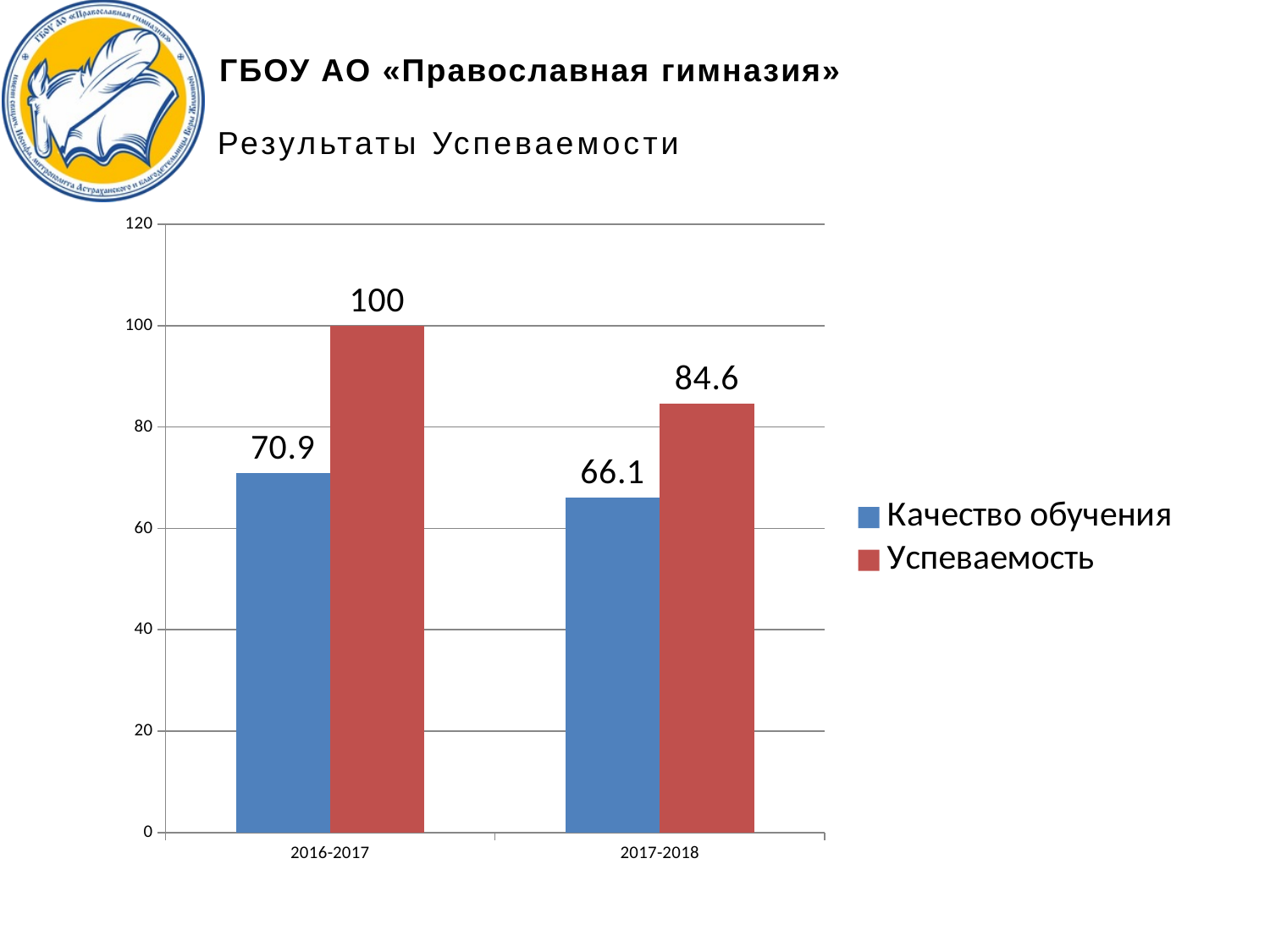
What kind of chart is shown on the slide? bar chart What is the value of Успеваемость for 2017-2018? 84.6 Which category has the lowest Качество обучения value? 2017-2018 What is the value of Качество обучения for 2017-2018? 66.1 What is the difference between Успеваемость in 2016-2017 and 2017-2018? 15.4 What is the value of Успеваемость for 2016-2017? 100 What is the value of Качество обучения for 2016-2017? 70.9 What is the difference between Успеваемость and Качество обучения in 2017-2018? 18.5 How many series does the legend list? 2 Which category has the highest Успеваемость value? 2016-2017 Which is larger in 2016-2017: Качество обучения or Успеваемость? Успеваемость How many categories are shown on the x axis? 2